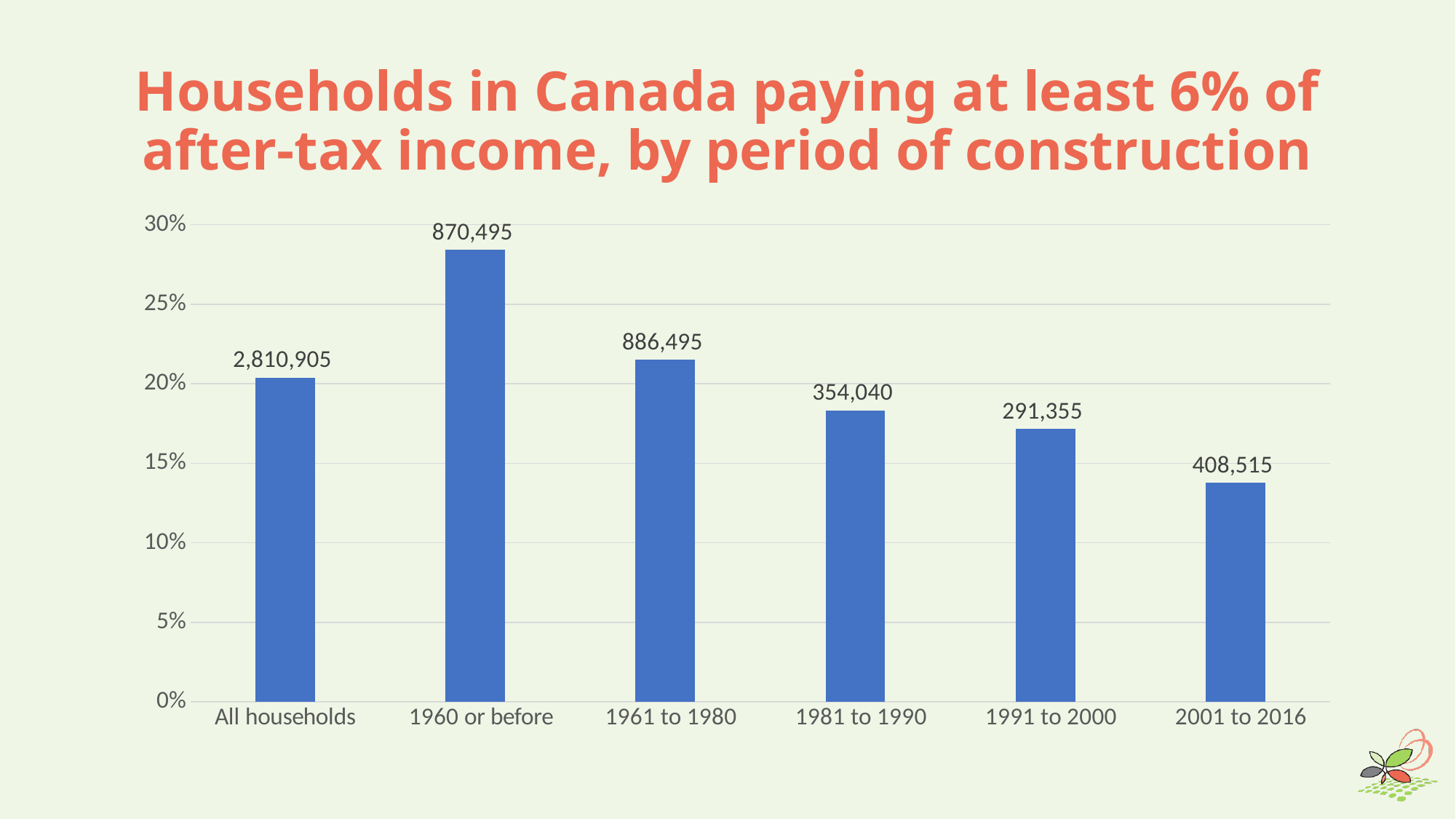
What type of chart is shown on the slide? Bar chart Is the percentage for 2001 to 2016 greater or less than 15%? less Which category has the tallest bar in the chart? 1960 or before Moving from 1960 or before to 2001 to 2016, do the bar heights generally rise or fall? fall What is the data label shown above the bar for All households? 2,810,905 Which bar is taller: 1961 to 1980 or 1981 to 1990? 1961 to 1980 Which category has the shortest bar in the chart? 2001 to 2016 What is the data label shown above the bar for 1960 or before? 870,495 Is the percentage for 1960 or before greater or less than 25%? greater What is the difference between the data labels for 1961 to 1980 and 1960 or before? 16,000 What is the data label shown above the bar for 1981 to 1990? 354,040 How many categories are shown along the x axis of the chart? 6